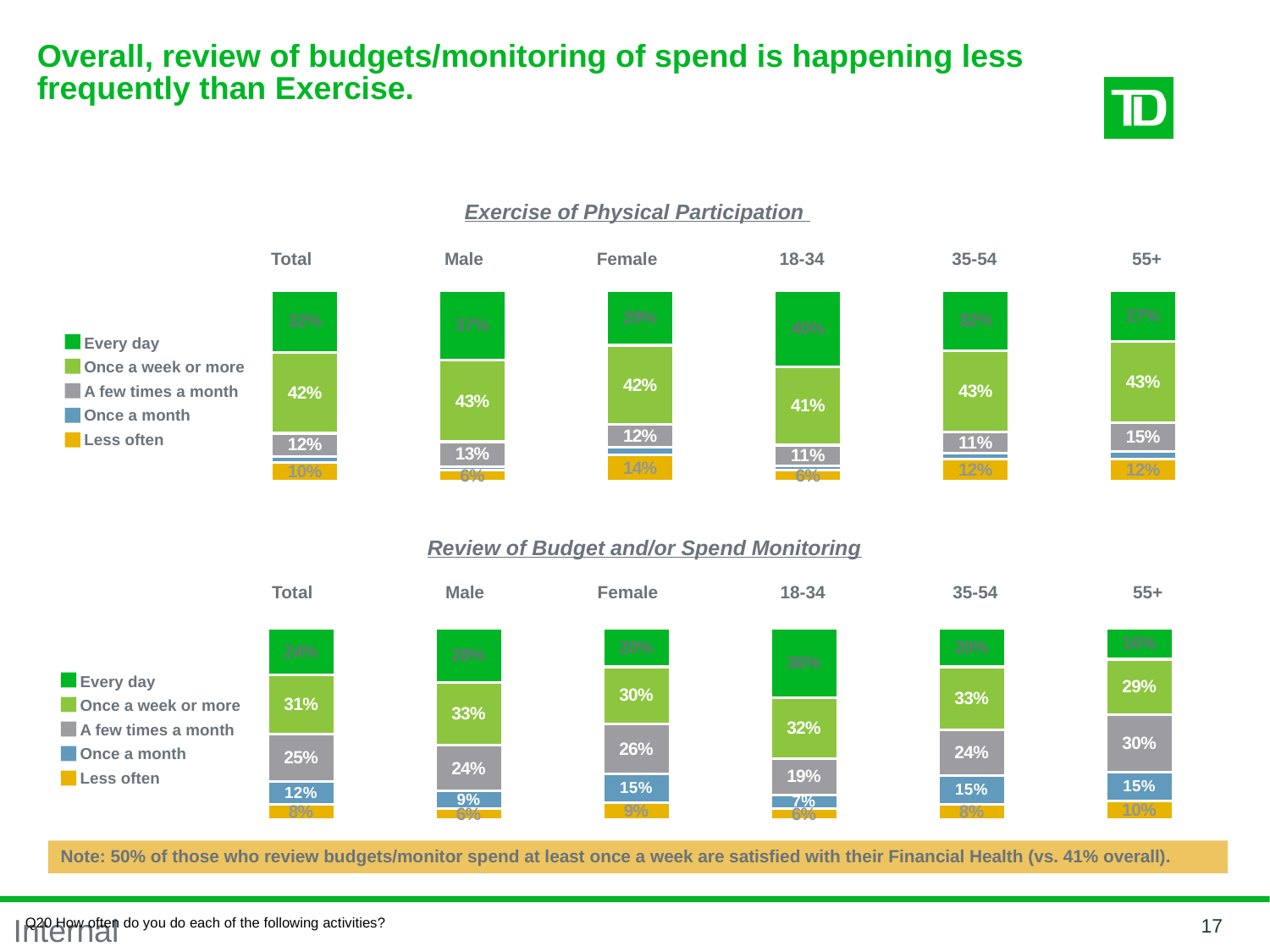
What is the title of the lower chart on the slide? Review of Budget and/or Spend Monitoring In the Exercise of Physical Participation chart, what percentage of Males exercise once a week or more? 43% In the Exercise of Physical Participation chart, what is the 'A few times a month' value for the 55+ group? 15% In the Exercise of Physical Participation chart, how many percentage points higher is the 'A few times a month' value for 55+ than for Total? 3 percentage points In the Review of Budget and/or Spend Monitoring chart, which group has the highest 'A few times a month' value? 55+ In the Review of Budget and/or Spend Monitoring chart, which group has the lowest 'Once a month' value? 18-34 How many categories does the legend of the Review of Budget and/or Spend Monitoring chart list? 5 In the Review of Budget and/or Spend Monitoring chart, what is the 'Once a month' value for Females? 15% What type of chart is used for the Exercise of Physical Participation data? Stacked bar chart How many groups (bars) are shown in the Exercise of Physical Participation chart? 6 In the Review of Budget and/or Spend Monitoring chart, is the 'Once a month' value larger for Total or for Male? Total In the Review of Budget and/or Spend Monitoring chart, what percentage of the 55+ group review their budget a few times a month? 30%